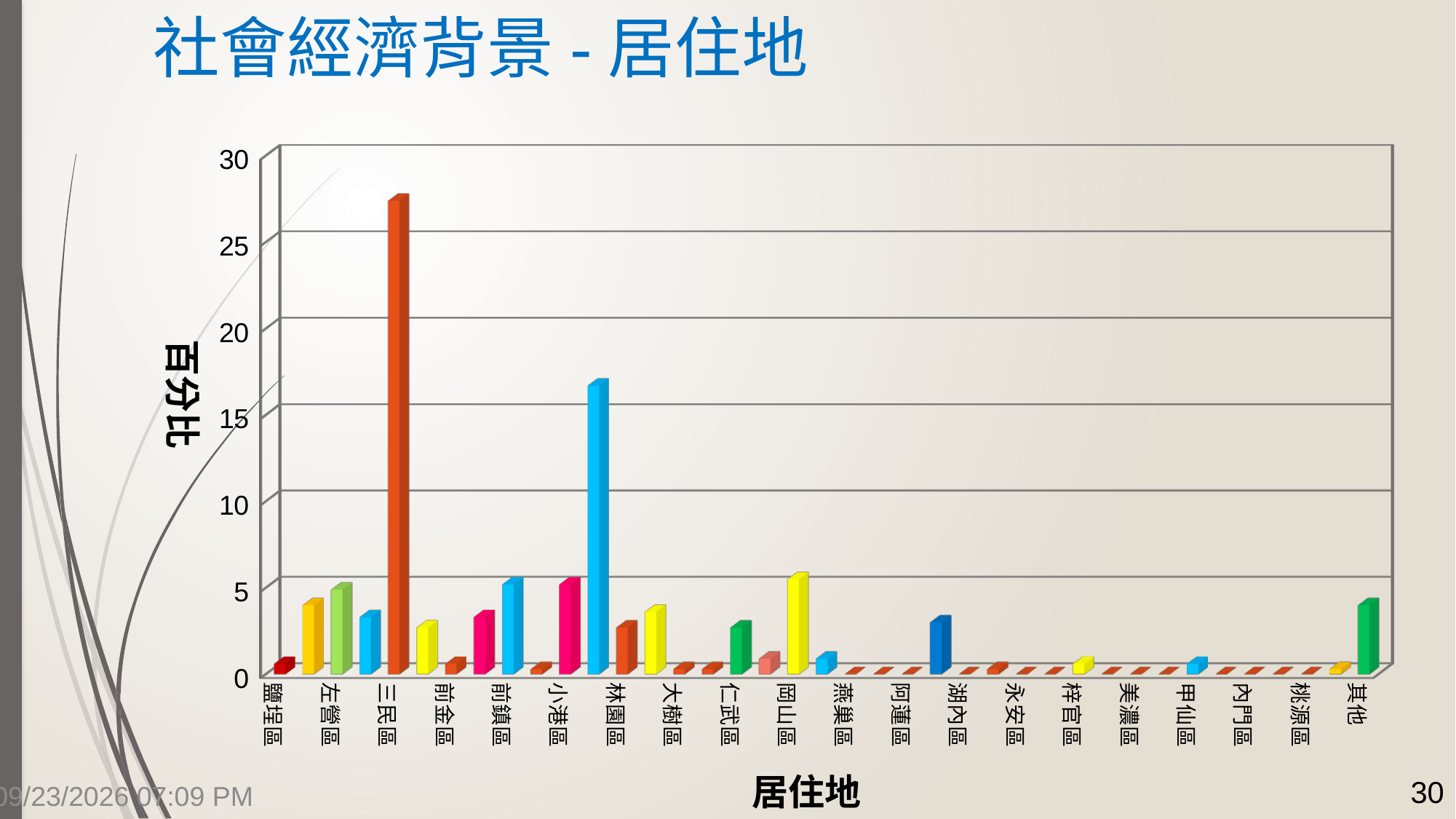
What kind of chart is shown on the slide? bar chart Which 居住地 has the highest 百分比 in the chart? 三民區 Is the value for 三民區 greater or less than 30? less What is the label of the vertical axis of the chart? 百分比 Is the value for 林園區 greater or less than 15? less Is the value for 仁武區 greater or less than 5? less Which has a larger value, 左營區 or 鹽埕區? 左營區 What is the label of the horizontal axis of the chart? 居住地 Which has a larger value, 三民區 or 林園區? 三民區